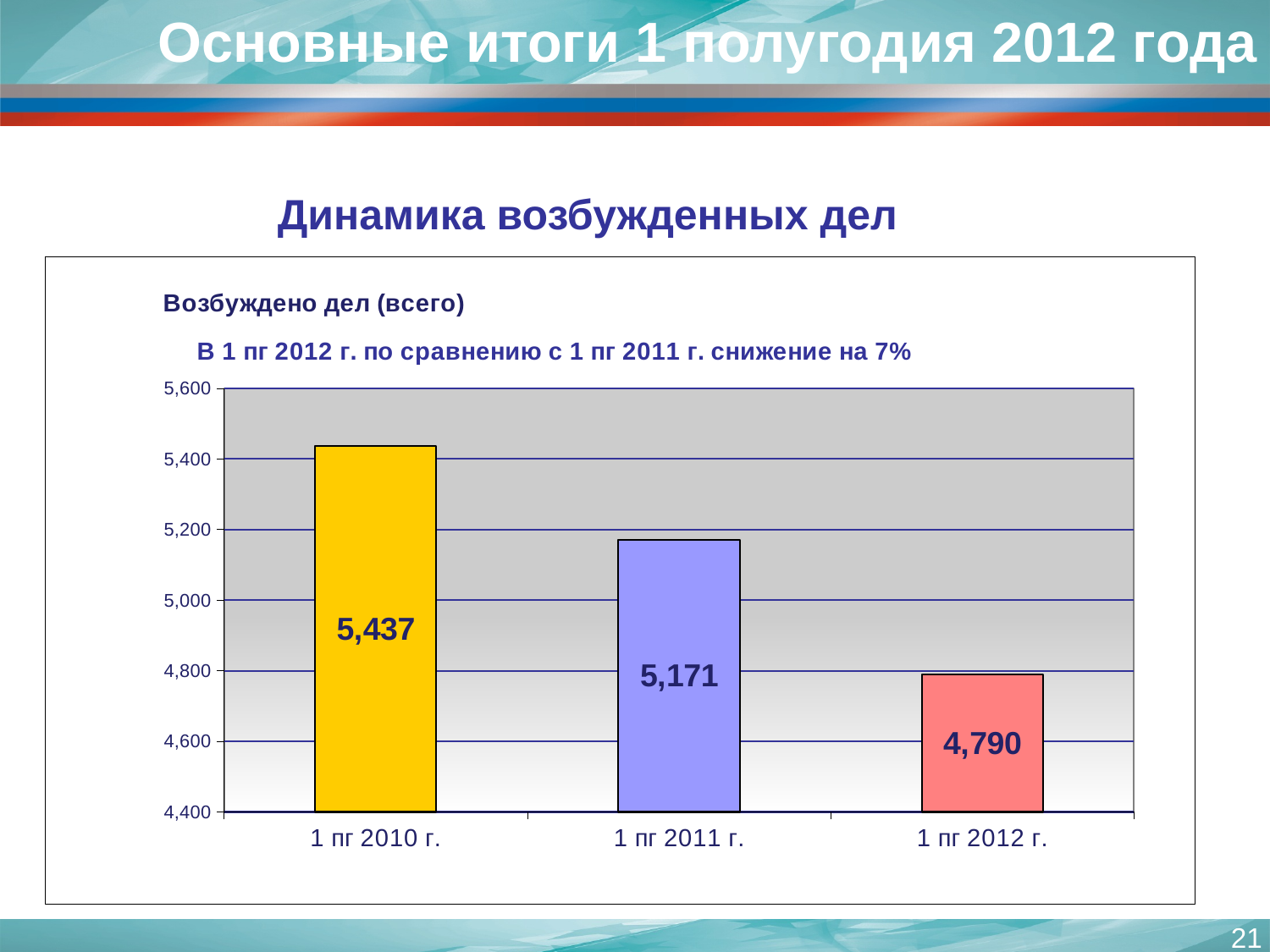
Is the value for 1 пг 2012 г. greater or less than 4,800? less What kind of chart is shown? bar chart What is the difference between the values for 1 пг 2011 г. and 1 пг 2012 г.? 381 What is the value for 1 пг 2010 г.? 5,437 Which period has the highest value? 1 пг 2010 г. Which is larger, the value for 1 пг 2010 г. or for 1 пг 2012 г.? 1 пг 2010 г. What is the difference between the values for 1 пг 2010 г. and 1 пг 2011 г.? 266 What is the value for 1 пг 2011 г.? 5,171 How many periods are shown on the x axis? 3 Do the values rise or fall from 1 пг 2010 г. to 1 пг 2012 г.? fall Which period has the lowest value? 1 пг 2012 г. What is the value for 1 пг 2012 г.? 4,790